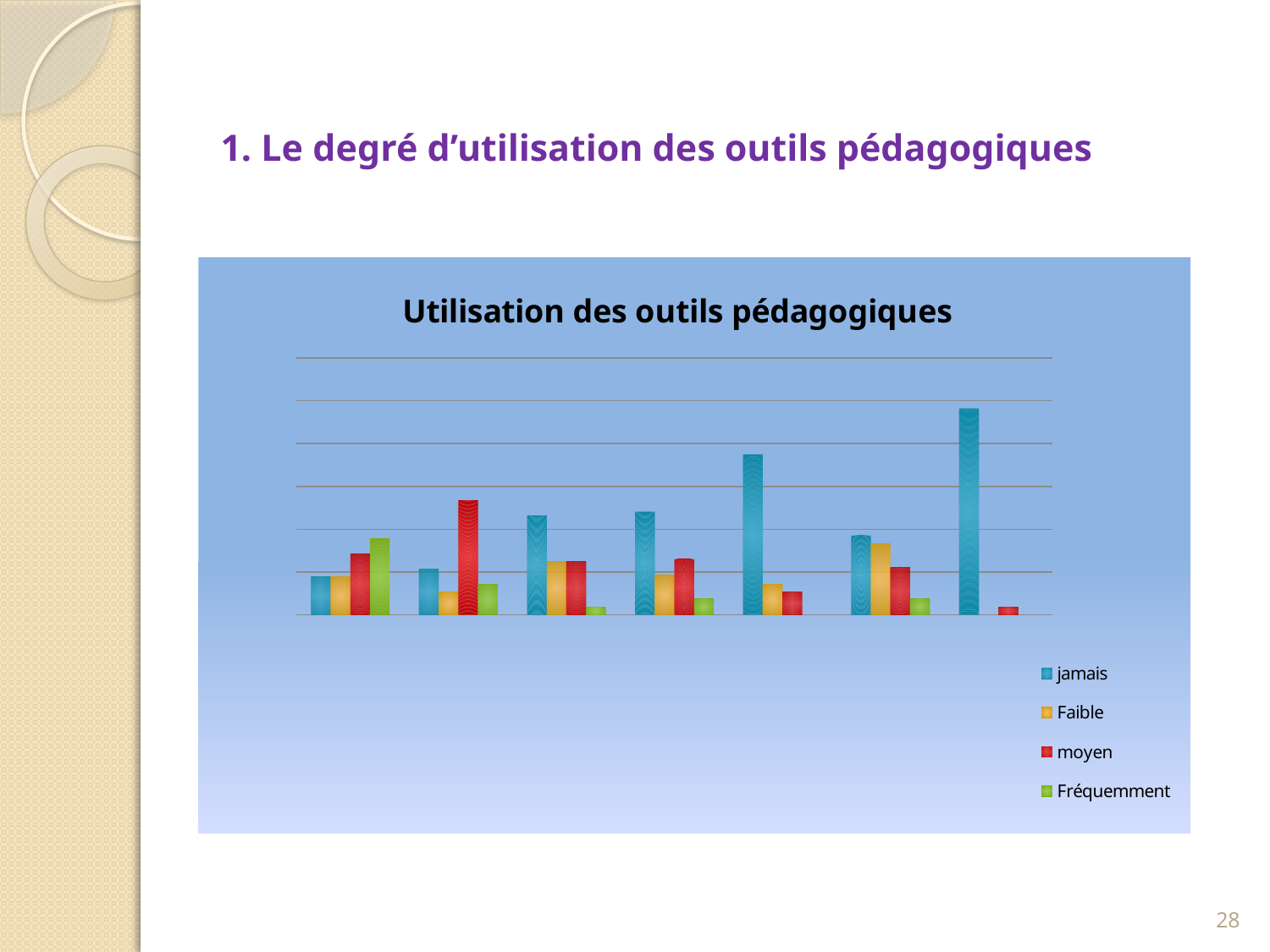
In the leftmost group of bars, which series has the tallest bar? Fréquemment What is the title of the chart? Utilisation des outils pédagogiques Which series are listed in the chart legend? jamais, Faible, moyen, Fréquemment How many groups of bars are plotted in the chart? 7 What type of chart is shown on the slide? bar chart In the second group of bars from the left, which series has the taller bar, jamais or moyen? moyen How many series does the chart legend list? 4 Which series has the tallest bar anywhere in the chart? jamais In the rightmost group of bars, which series has the taller bar, jamais or moyen? jamais In the fifth group of bars from the left, which series has the tallest bar? jamais